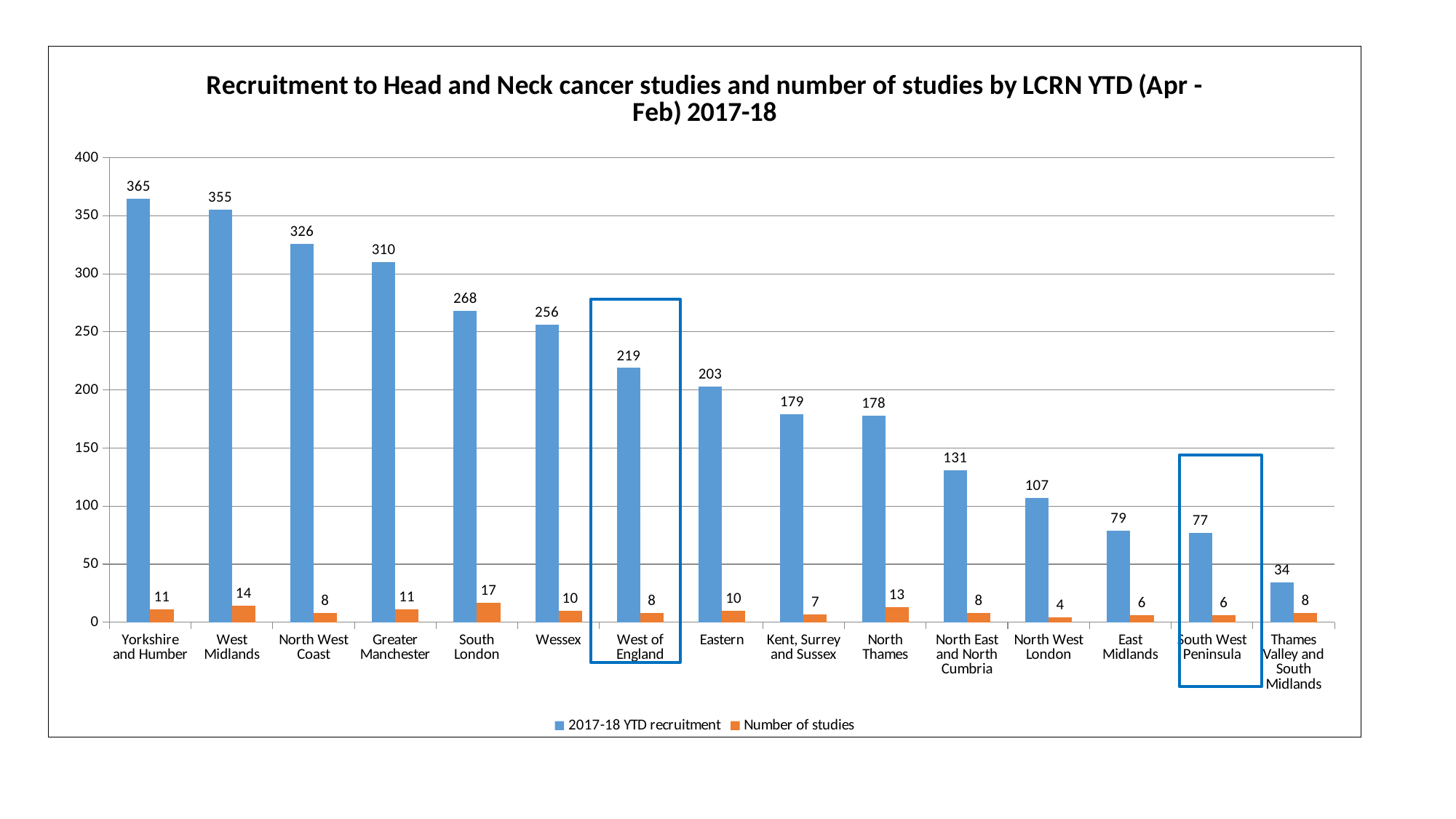
How many LCRNs are shown on the x axis? 15 What kind of chart is shown on the slide? Bar chart How many studies does South London have? 17 Which LCRN has the lowest 2017-18 YTD recruitment? Thames Valley and South Midlands How many series does the legend list? 2 Which LCRN has the highest 2017-18 YTD recruitment? Yorkshire and Humber What colour are the bars for Number of studies? Orange Do the 2017-18 YTD recruitment values rise or fall from left to right along the x axis? Fall What is the 2017-18 YTD recruitment for West of England? 219 Which has higher 2017-18 YTD recruitment, Greater Manchester or South London? Greater Manchester Which LCRN has the lowest number of studies? North West London What is the difference in 2017-18 YTD recruitment between Yorkshire and Humber and West Midlands? 10